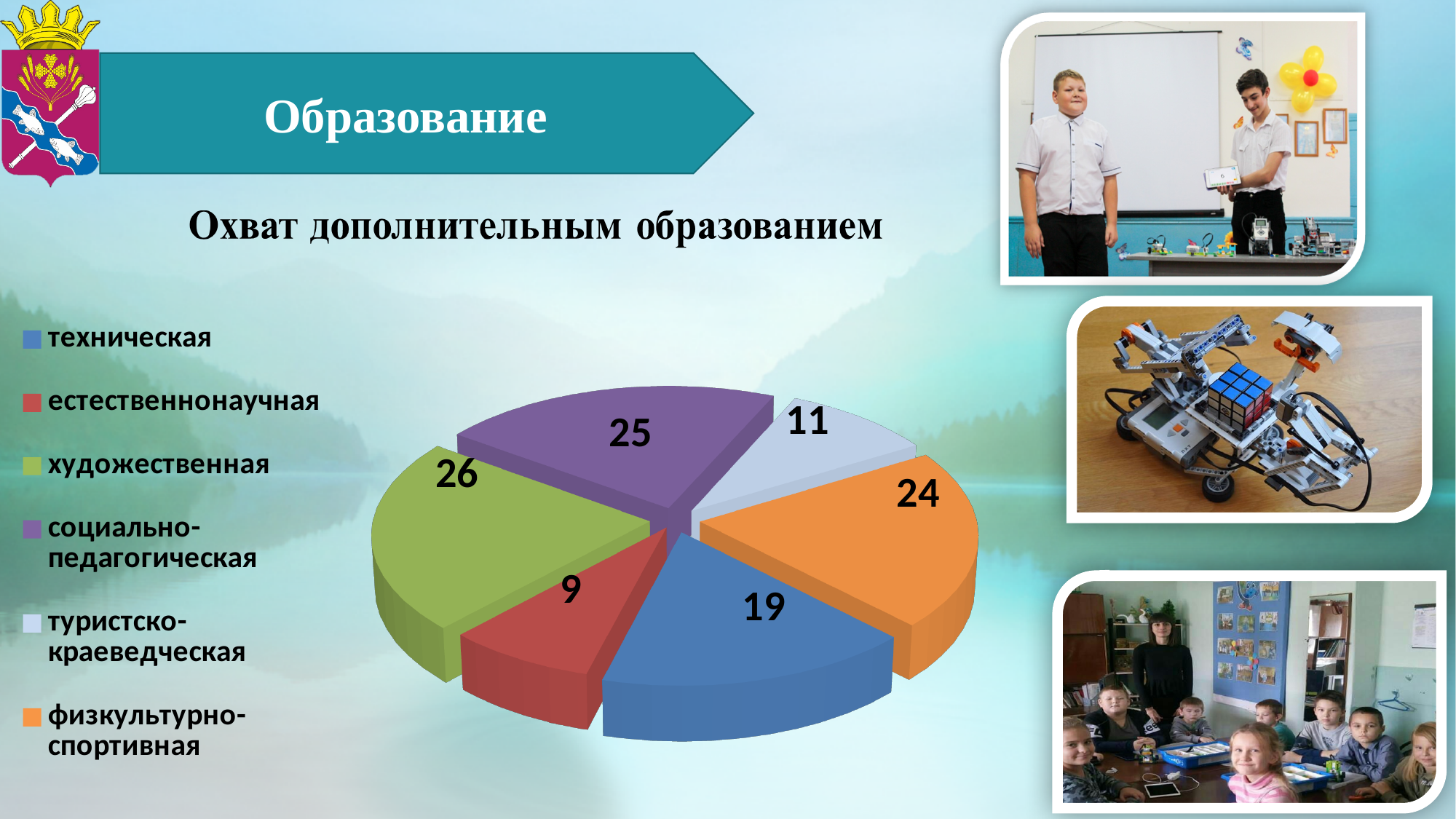
What is the value for туристско-краеведческая? 11 What is the value for физкультурно-спортивная? 24 What is the difference between the values for художественная and социально-педагогическая? 1 How many slices does the pie chart have? 6 What is the value for естественнонаучная? 9 What is the value for техническая? 19 What is the title of the chart? Охват дополнительным образованием Which colour represents социально-педагогическая in the legend? purple Which category has the highest value? художественная What kind of chart is shown on the slide? pie chart Which is larger, the value for техническая or the value for физкультурно-спортивная? физкультурно-спортивная Which category has the lowest value? естественнонаучная